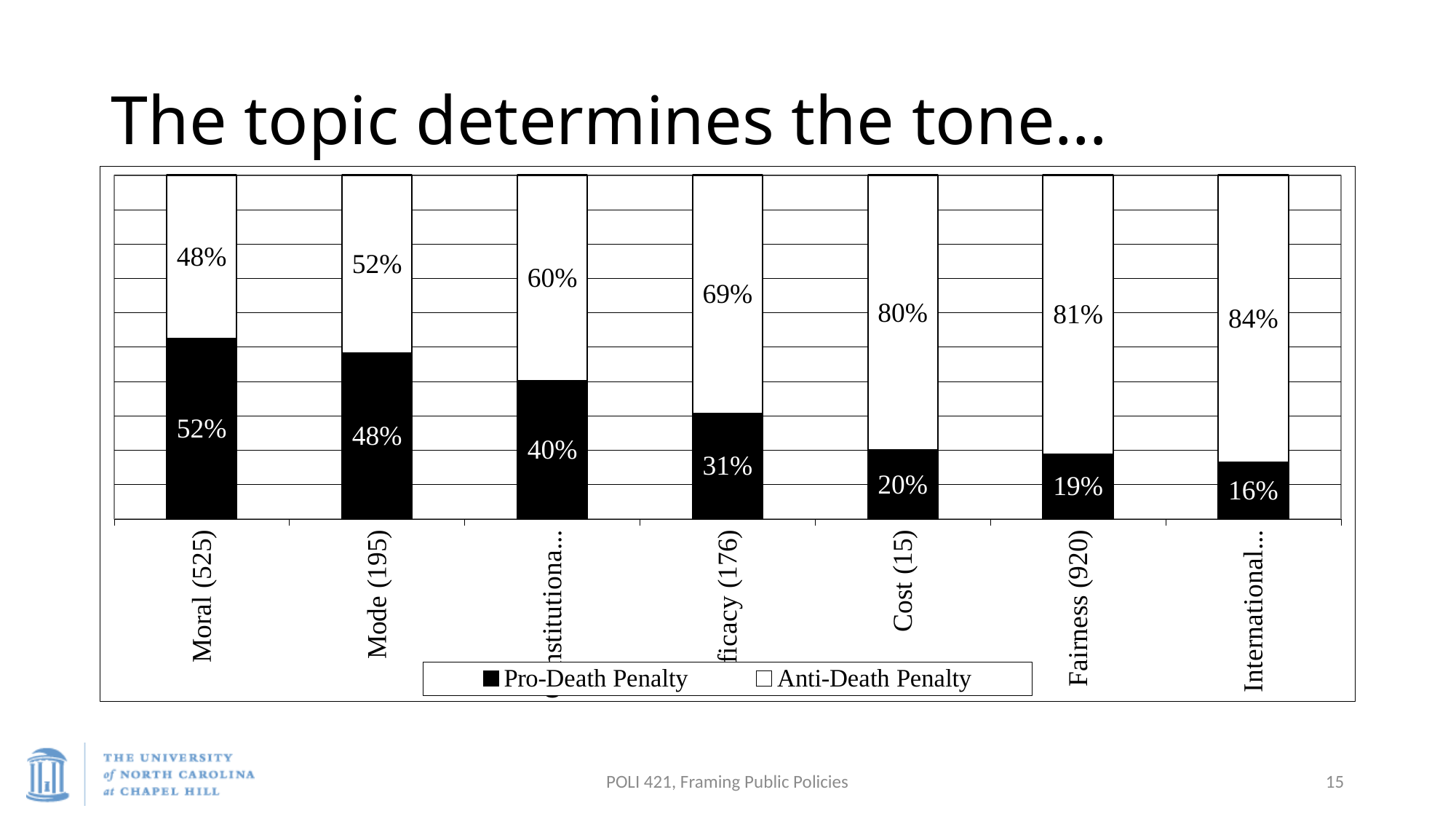
Which has the larger Pro-Death Penalty share, Moral (525) or Mode (195)? Moral (525) Which category has the lowest Pro-Death Penalty share? International What is the Anti-Death Penalty value for Mode (195)? 52% How many categories are shown on the x axis? 7 What is the Pro-Death Penalty value for Fairness (920)? 19% What is the Anti-Death Penalty value for Cost (15)? 80% Does the Pro-Death Penalty share rise or fall moving from left to right across the categories? Fall How many series does the legend list? 2 For Cost (15), how much larger is the Anti-Death Penalty share than the Pro-Death Penalty share? 60 percentage points What kind of chart is shown on the slide? Stacked bar chart What is the Pro-Death Penalty value for Moral (525)? 52% Which category has the highest Pro-Death Penalty share? Moral (525)